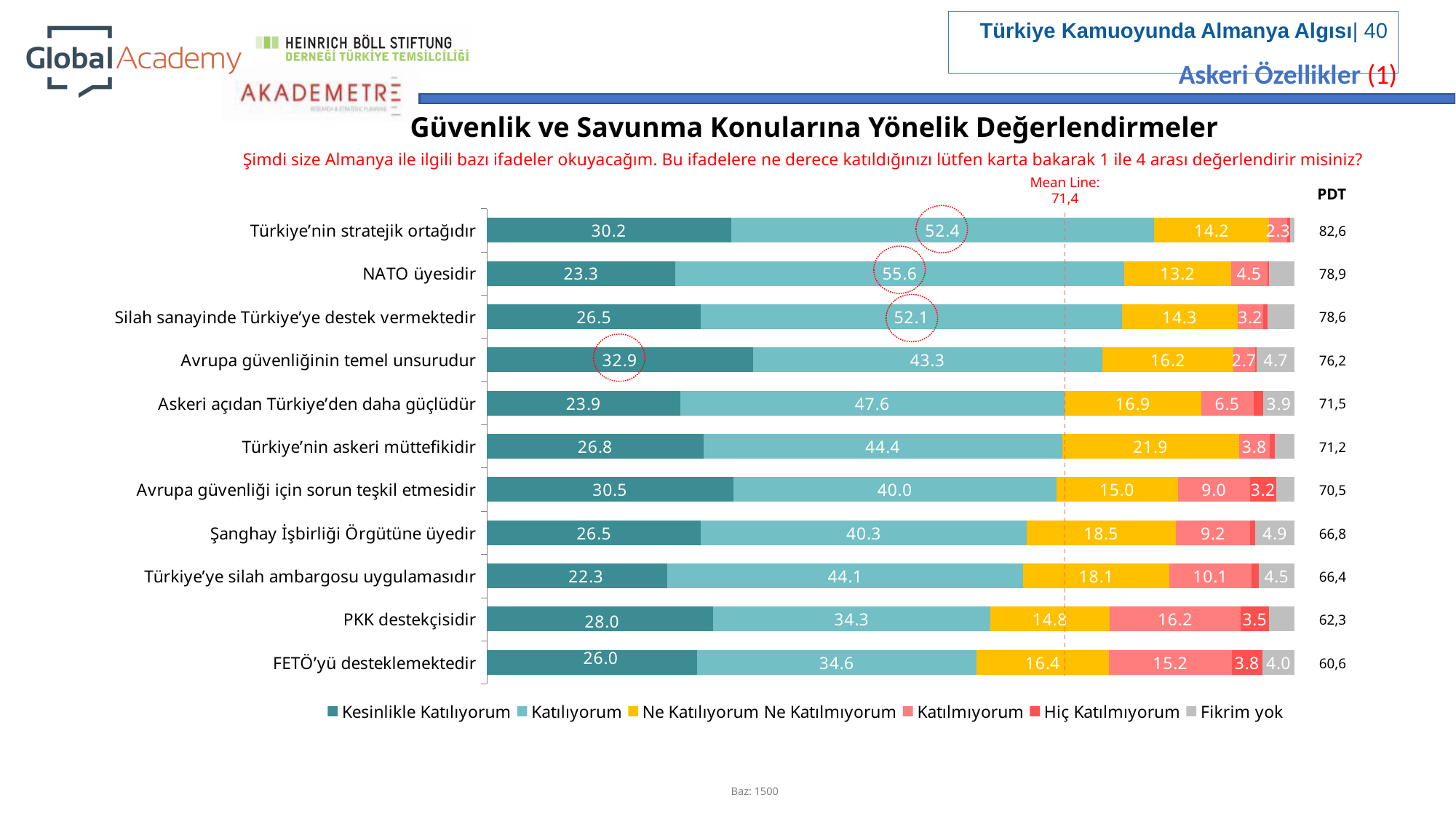
Which statement has the highest 'Katılıyorum' value? NATO üyesidir What value is given for the Mean Line in the chart? 71,4 How many series does the chart legend list? 6 Which has the larger 'Ne Katılıyorum Ne Katılmıyorum' value: 'Türkiye'nin askeri müttefikidir' or 'Şanghay İşbirliği Örgütüne üyedir'? Türkiye'nin askeri müttefikidir What kind of chart is shown on the slide? bar chart How many statements (categories) are plotted in the chart? 11 What is the 'Kesinlikle Katılıyorum' value for 'Türkiye'nin stratejik ortağıdır'? 30.2 What is the PDT value shown for 'FETÖ'yü desteklemektedir'? 60,6 What is the difference in 'Kesinlikle Katılıyorum' between 'Avrupa güvenliği için sorun teşkil etmesidir' and 'Türkiye'ye silah ambargosu uygulamasıdır'? 8.2 What is the 'Katılmıyorum' value for 'PKK destekçisidir'? 16.2 Which statement has the highest 'Kesinlikle Katılıyorum' value? Avrupa güvenliğinin temel unsurudur What is the 'Katılıyorum' value for 'NATO üyesidir'? 55.6